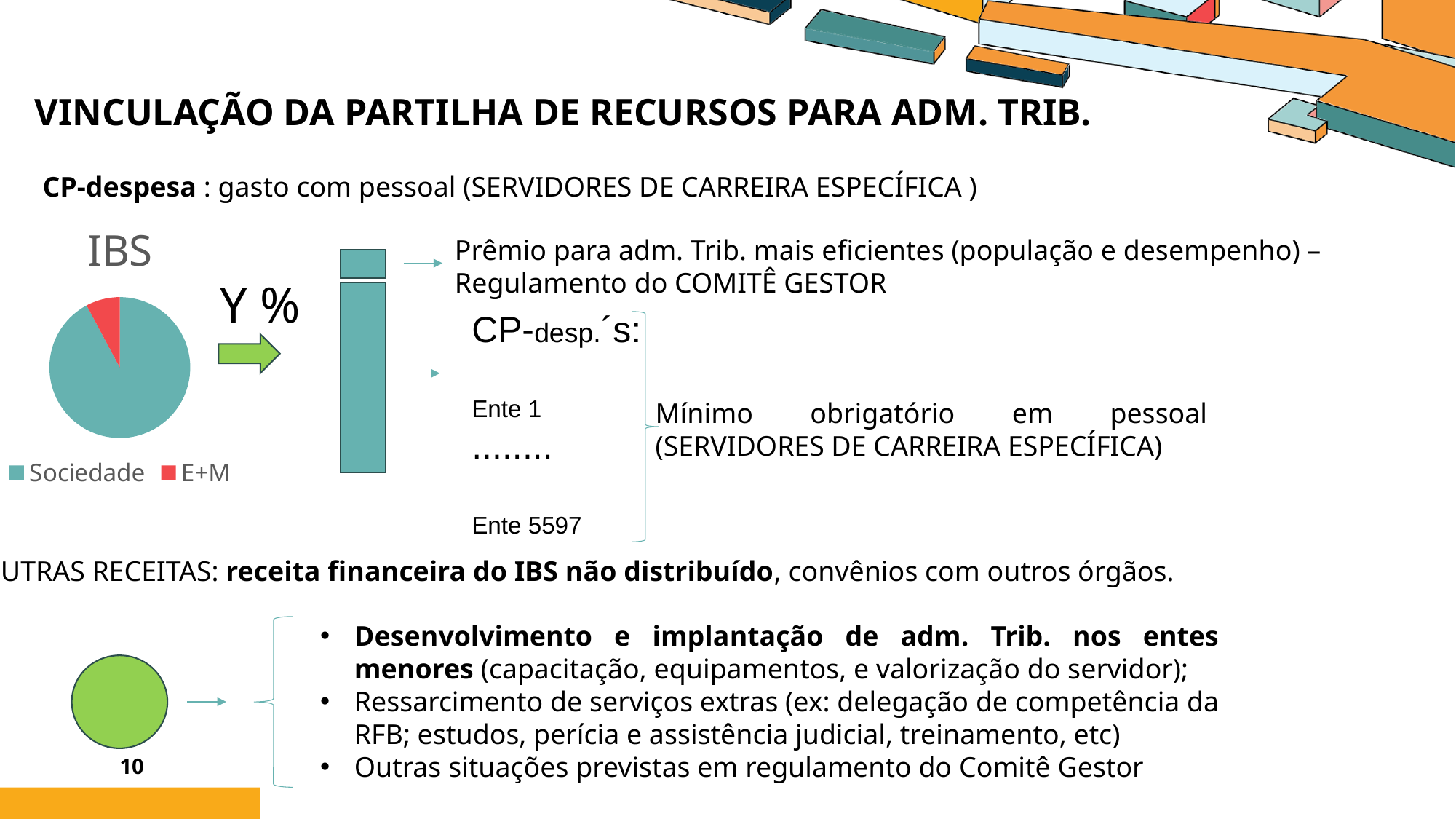
What are the two legend entries of the IBS pie chart? Sociedade and E+M In the IBS pie chart, which slice is larger, Sociedade or E+M? Sociedade Which category has the largest slice in the IBS pie chart? Sociedade Which category has the smallest slice in the IBS pie chart? E+M What colour is the E+M slice in the IBS pie chart? Red How many categories does the legend of the IBS pie chart list? 2 What is the title of the pie chart on the slide? IBS What kind of chart is the IBS chart on the left of the slide? Pie chart